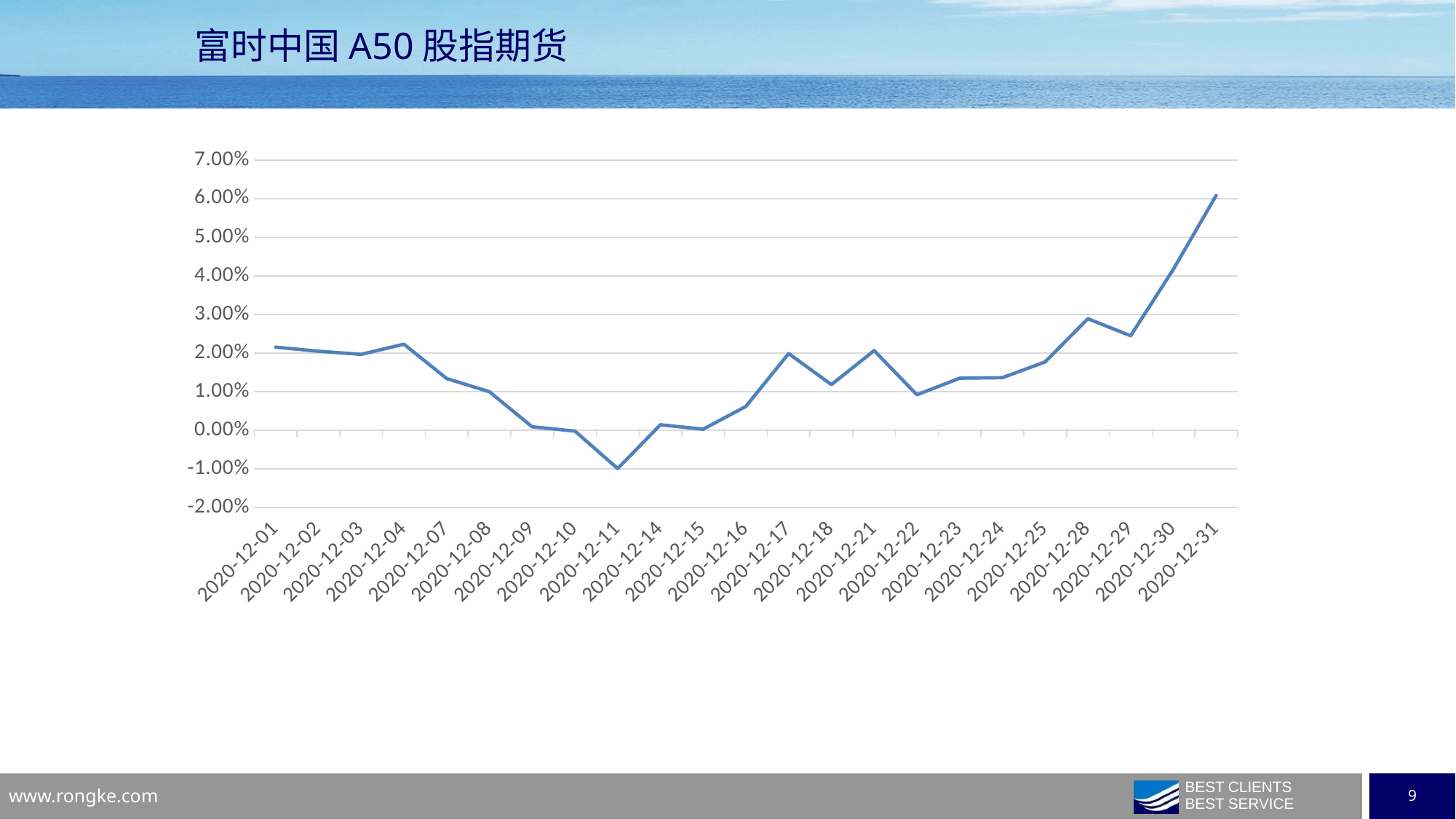
Is the value for 2020-12-09 greater or less than 1.00%? less Is the value for 2020-12-11 greater or less than 0.00%? less Which has the larger value, 2020-12-01 or 2020-12-31? 2020-12-31 On which date is the value highest? 2020-12-31 On which date is the value lowest? 2020-12-11 Which has the larger value, 2020-12-11 or 2020-12-14? 2020-12-14 Does the value rise or fall from 2020-12-25 to 2020-12-31? Rise Is the value for 2020-12-31 greater or less than 5.00%? greater How many dates are plotted along the x axis? 23 What kind of chart is shown on the slide? Line chart What is the title of the chart? 富时中国 A50 股指期货